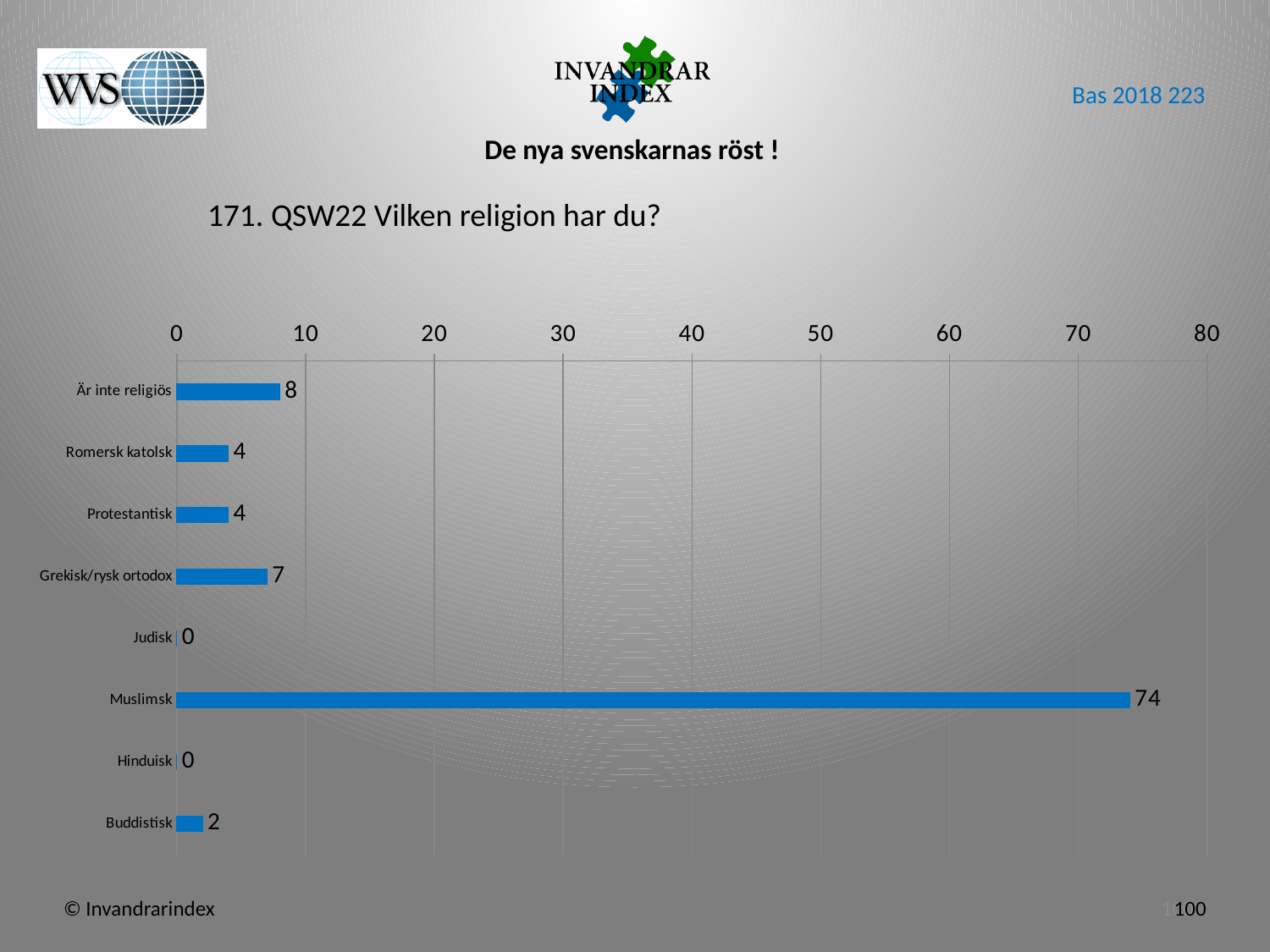
What is the value for Muslimsk? 74 What is the value for Buddistisk? 2 What is the value for Grekisk/rysk ortodox? 7 What is the question text shown above the chart? 171. QSW22 Vilken religion har du? How many categories are shown in the chart? 8 What is the difference between the values for Muslimsk and Är inte religiös? 66 What is the value for Är inte religiös? 8 Is the value for Muslimsk greater or less than 70? greater Which categories have a value of 0? Judisk and Hinduisk What kind of chart is shown on the slide? bar chart Which is larger, the value for Grekisk/rysk ortodox or the value for Romersk katolsk? Grekisk/rysk ortodox Which category has the highest value? Muslimsk